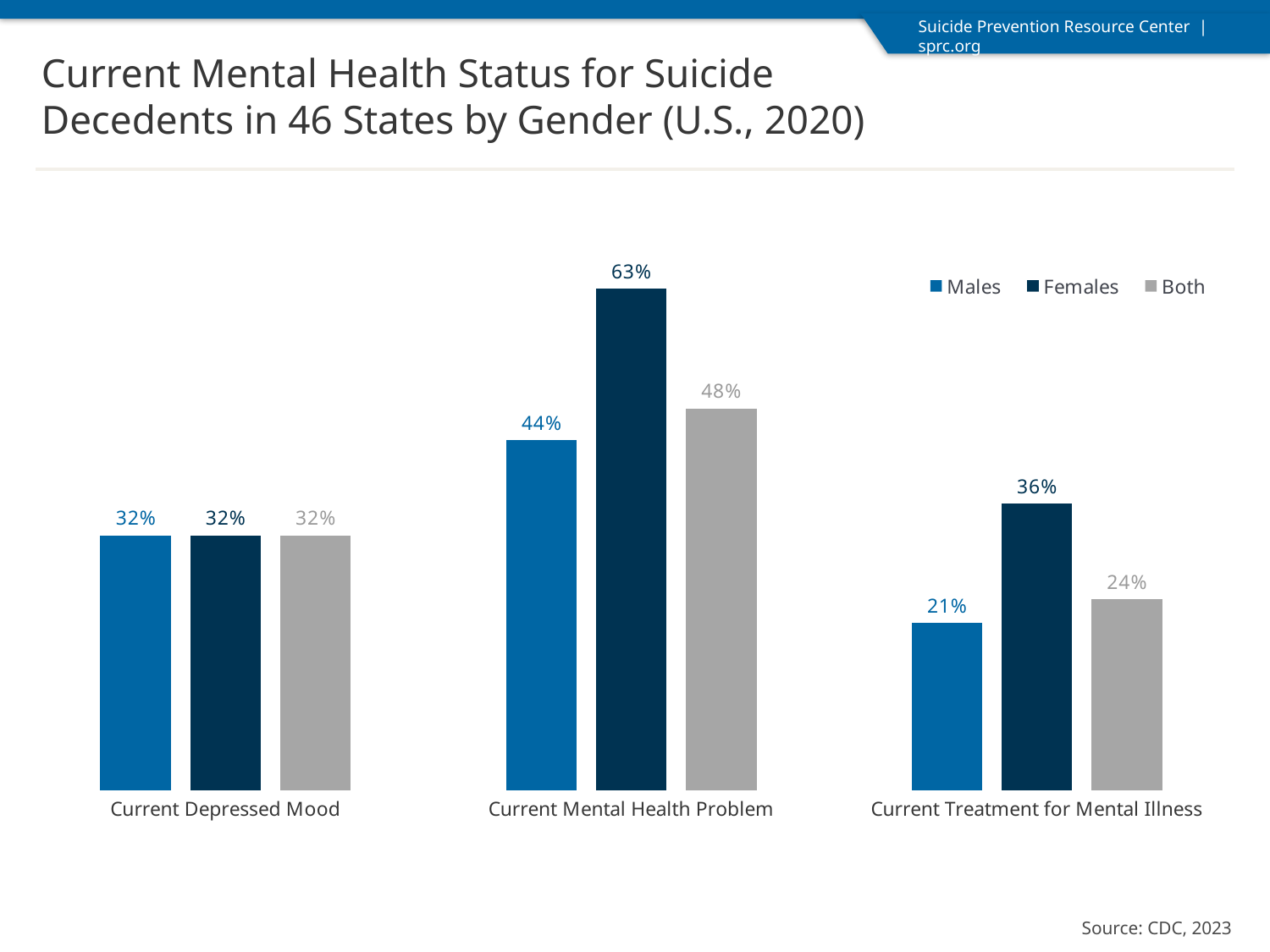
What is the source cited for the chart? CDC, 2023 Which is larger in the Current Treatment for Mental Illness category, the Males value or the Both value? Both What is the value for Females in the Current Mental Health Problem category? 63% What is the difference between the Females and Both values in the Current Treatment for Mental Illness category? 12% How many series does the legend list? 3 Which category has the lowest value for Males? Current Treatment for Mental Illness How many categories are shown on the x axis? 3 What is the value for Both in the Current Depressed Mood category? 32% What is the difference between the Females and Males values in the Current Mental Health Problem category? 19% Which category has the highest value for Females? Current Mental Health Problem What is the value for Males in the Current Treatment for Mental Illness category? 21% What kind of chart is shown on the slide? Bar chart